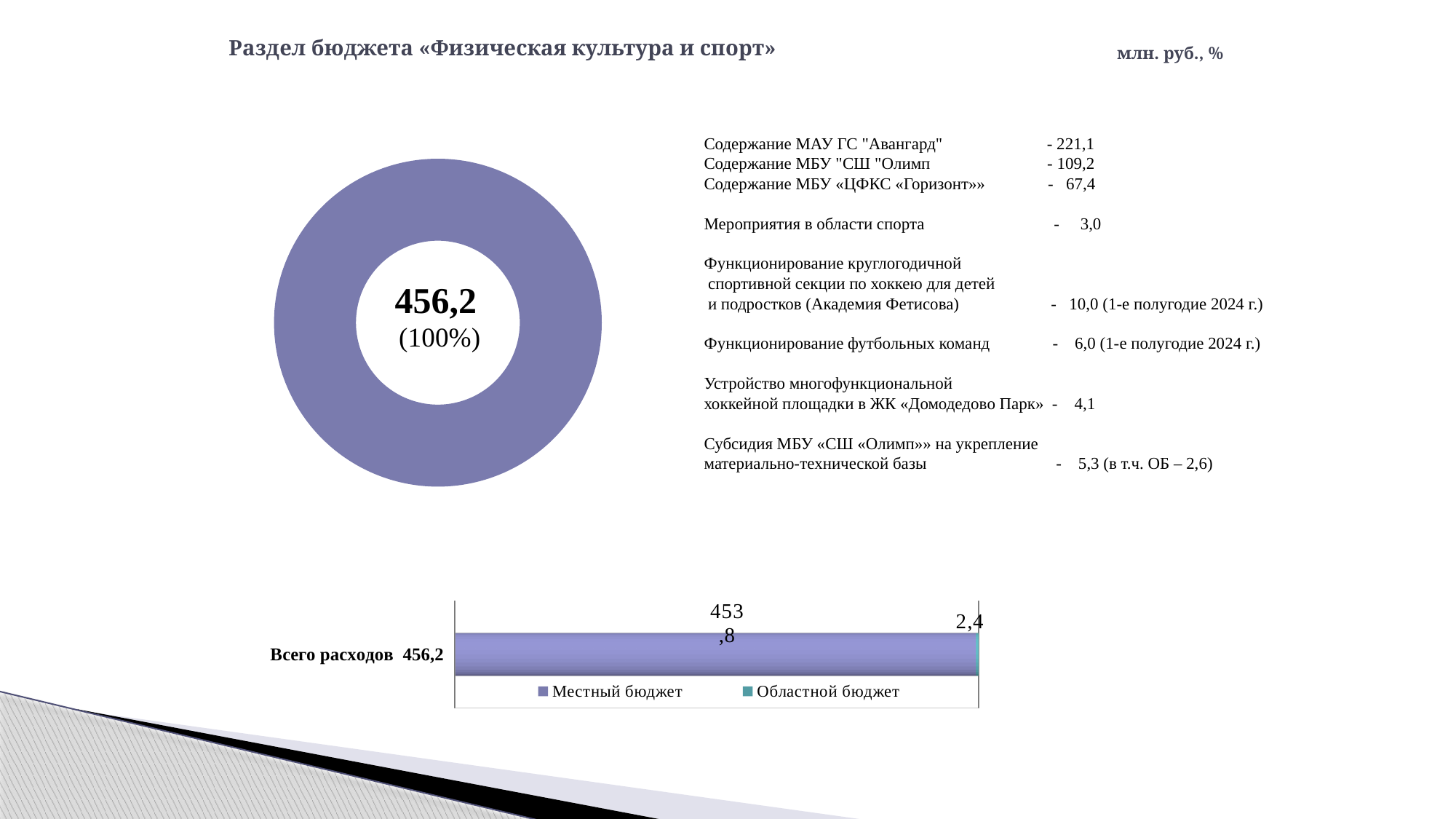
In the top-left donut chart, what share of the whole does the single slice represent? 100% In the bottom bar chart, what is the value for Местный бюджет? 453,8 In the bottom bar chart, how many series does the legend list? 2 In the bottom bar chart, what is the total of the stacked bar for Всего расходов? 456,2 In the bottom bar chart, which is larger: Местный бюджет or Областной бюджет? Местный бюджет What kind of chart is the chart at the bottom of the slide? bar chart What kind of chart is the chart at the top left of the slide? donut (pie) chart In the bottom bar chart, how many categories are plotted? 1 In the bottom bar chart, what are the two legend entries? Местный бюджет, Областной бюджет In the bottom bar chart, what is the value for Областной бюджет? 2,4 In the bottom bar chart, what is the difference between Местный бюджет and Областной бюджет? 451,4 In the top-left donut chart, what value is shown in the centre? 456,2